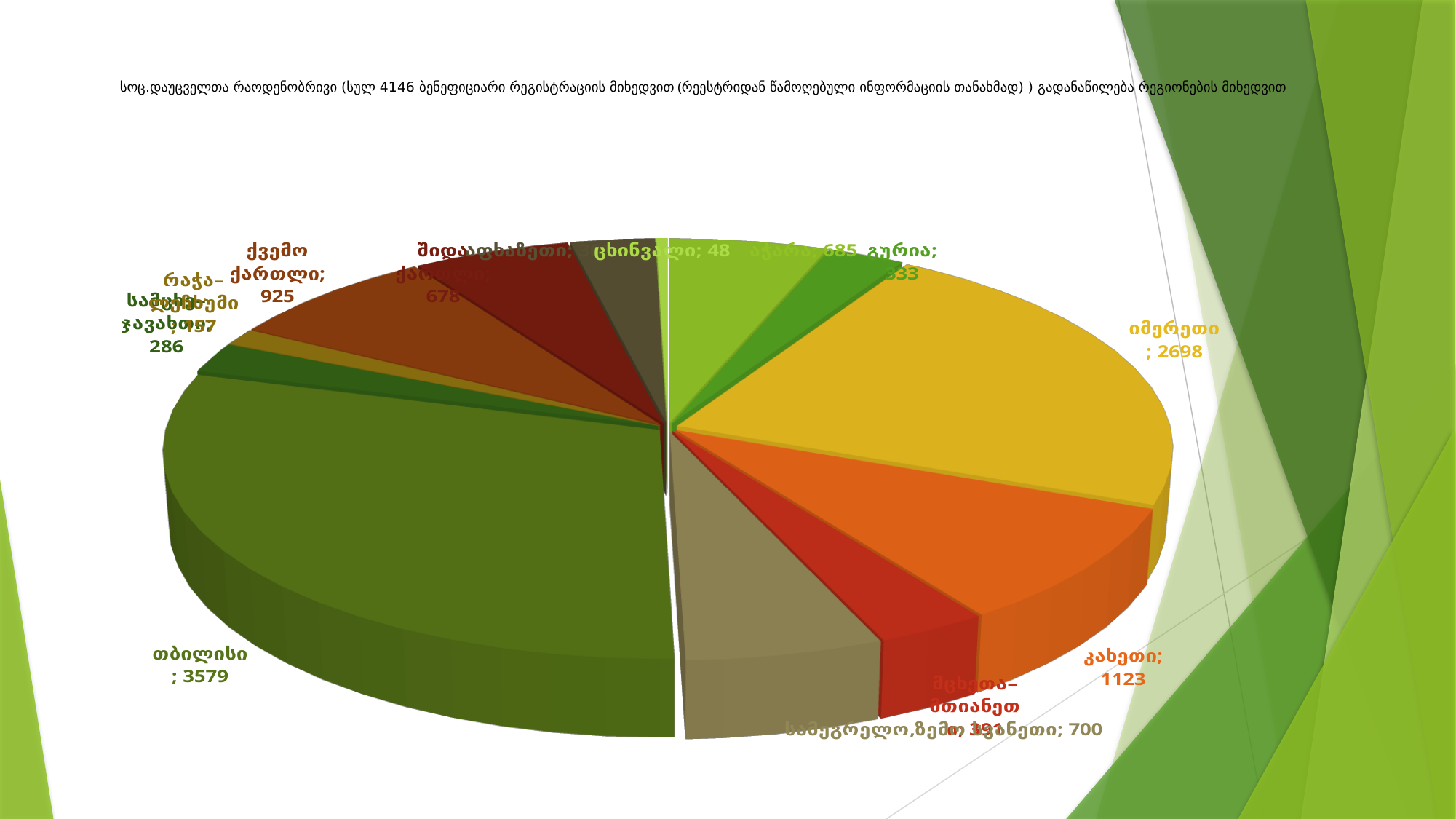
Which region has the smallest slice of the pie? ცხინვალი What is the difference between the values for თბილისი and იმერეთი? 881 Which region has the largest slice of the pie? თბილისი What is the value for ცხინვალი? 48 What is the value for თბილისი? 3579 What kind of chart is shown on the slide? pie chart Which is larger, the value for კახეთი or the value for ქვემო ქართლი? კახეთი What is the value for იმერეთი? 2698 What is the value for გურია? 333 What is the value for კახეთი? 1123 What is the value for ქვემო ქართლი? 925 What is the difference between the values for კახეთი and გურია? 790